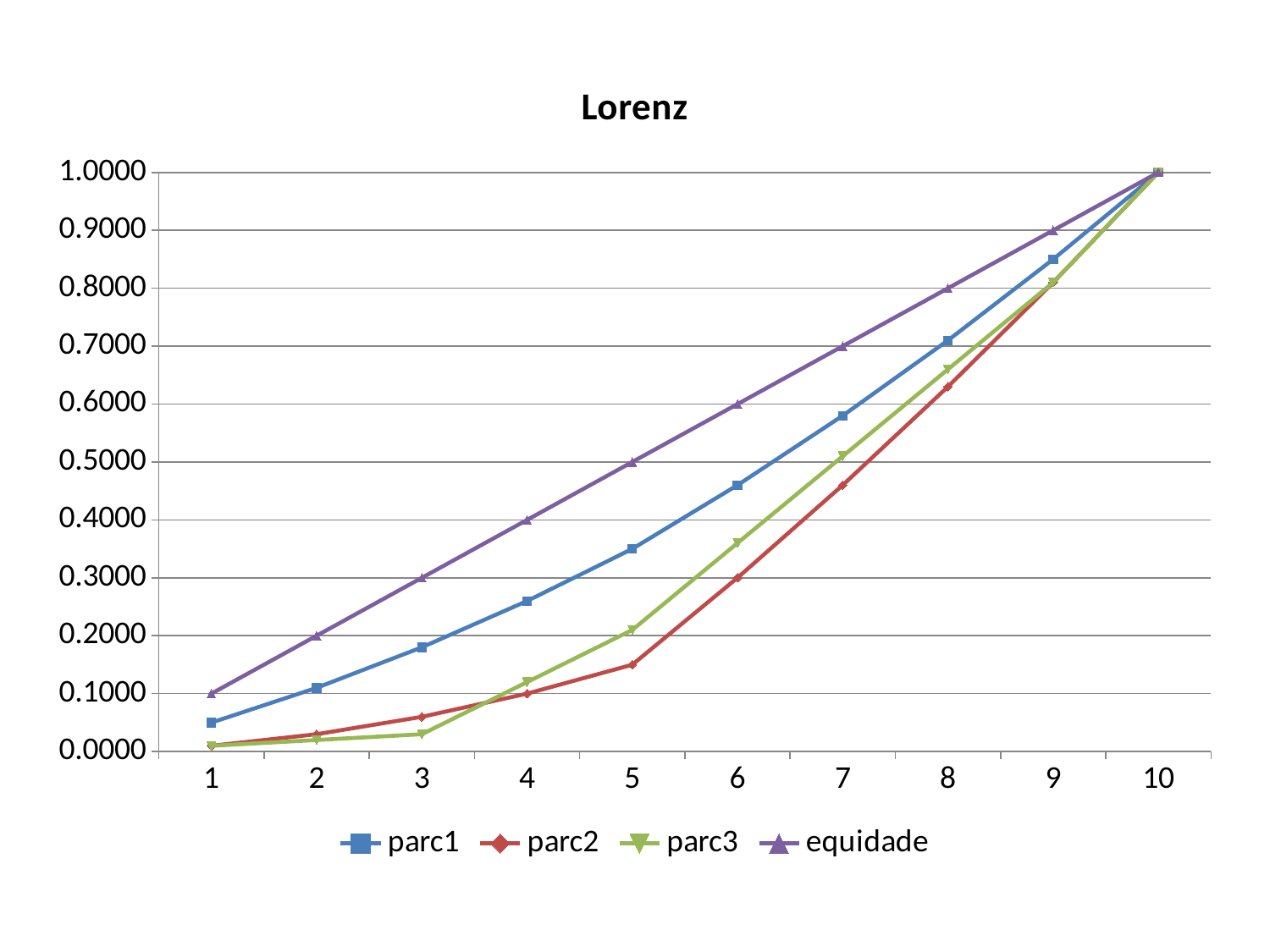
What is the value of equidade at x = 5? 0.5000 Is the value for parc1 at x = 5 greater or less than 0.3000? greater Which series has the highest value at x = 5? equidade Which series has the lowest value at x = 5? parc2 How many series does the legend list? 4 Is the value for parc2 at x = 7 greater or less than 0.5000? less What is the value of parc1 at x = 10? 1.0000 What is the value of equidade at x = 8? 0.8000 How many points are plotted along the x axis for each series? 10 What kind of chart is shown on the slide? line chart Do the values of parc1 rise or fall as x increases from 1 to 10? rise At x = 5, which is larger, parc1 or parc2? parc1